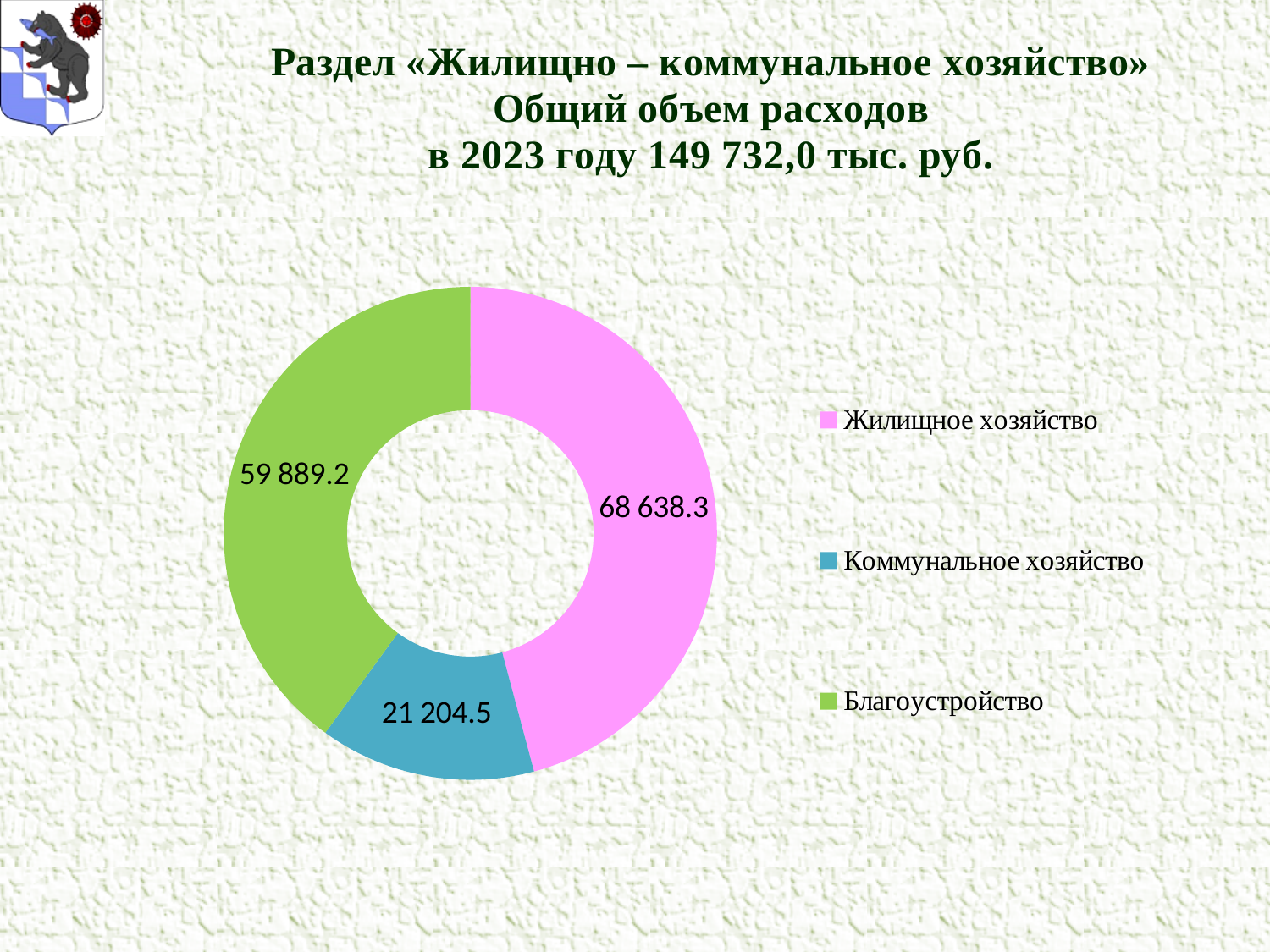
Which category has the smallest slice? Коммунальное хозяйство What is the difference between the values for Благоустройство and Коммунальное хозяйство? 38 684.7 What kind of chart is shown on the slide? doughnut (pie) chart What is the total of all three slices? 149 732.0 What colour is the slice for Коммунальное хозяйство? blue What is the value for Коммунальное хозяйство? 21 204.5 Which category has the largest slice? Жилищное хозяйство What is the value for Жилищное хозяйство? 68 638.3 How many categories does the chart show? 3 Which is larger, the value for Благоустройство or the value for Коммунальное хозяйство? Благоустройство What is the value for Благоустройство? 59 889.2 What is the difference between the values for Жилищное хозяйство and Благоустройство? 8 749.1